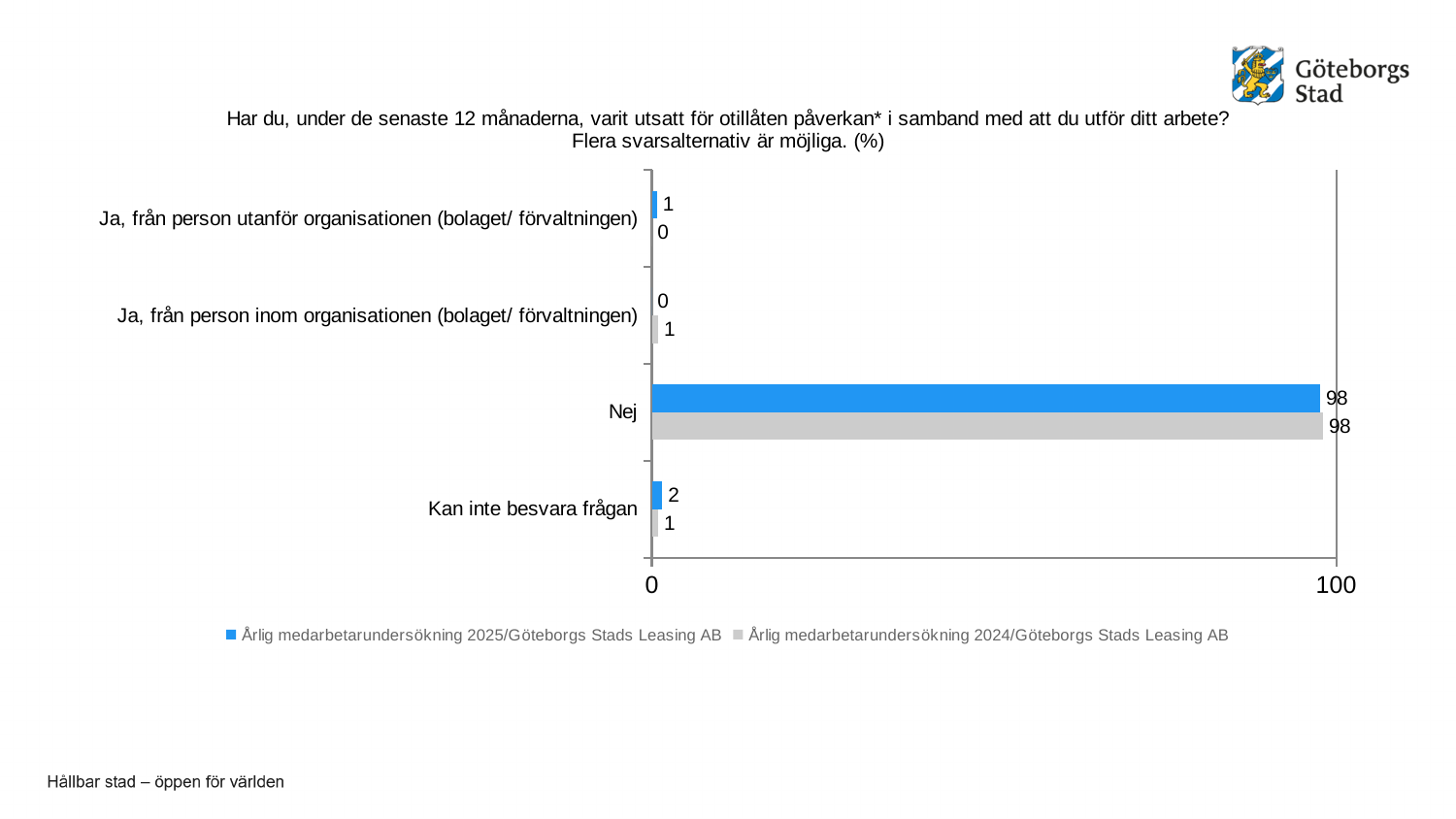
What is the difference between the 2025 and 2024 values for "Kan inte besvara frågan"? 1 For "Kan inte besvara frågan", which series has the larger value, 2025 or 2024? Årlig medarbetarundersökning 2025/Göteborgs Stads Leasing AB Which colour represents the Årlig medarbetarundersökning 2024/Göteborgs Stads Leasing AB series? grey What is the value for "Ja, från person inom organisationen (bolaget/ förvaltningen)" in the Årlig medarbetarundersökning 2024/Göteborgs Stads Leasing AB series? 1 What is the value for "Kan inte besvara frågan" in the Årlig medarbetarundersökning 2025/Göteborgs Stads Leasing AB series? 2 How many series does the legend list? 2 What kind of chart is shown on the slide? bar chart What is the difference between the value for "Nej" and the value for "Kan inte besvara frågan" in the 2025 series? 96 Which category has the highest value in the Årlig medarbetarundersökning 2025/Göteborgs Stads Leasing AB series? Nej What is the value for "Nej" in the Årlig medarbetarundersökning 2025/Göteborgs Stads Leasing AB series? 98 What is the value for "Ja, från person utanför organisationen (bolaget/ förvaltningen)" in the Årlig medarbetarundersökning 2025/Göteborgs Stads Leasing AB series? 1 How many categories are shown on the chart? 4